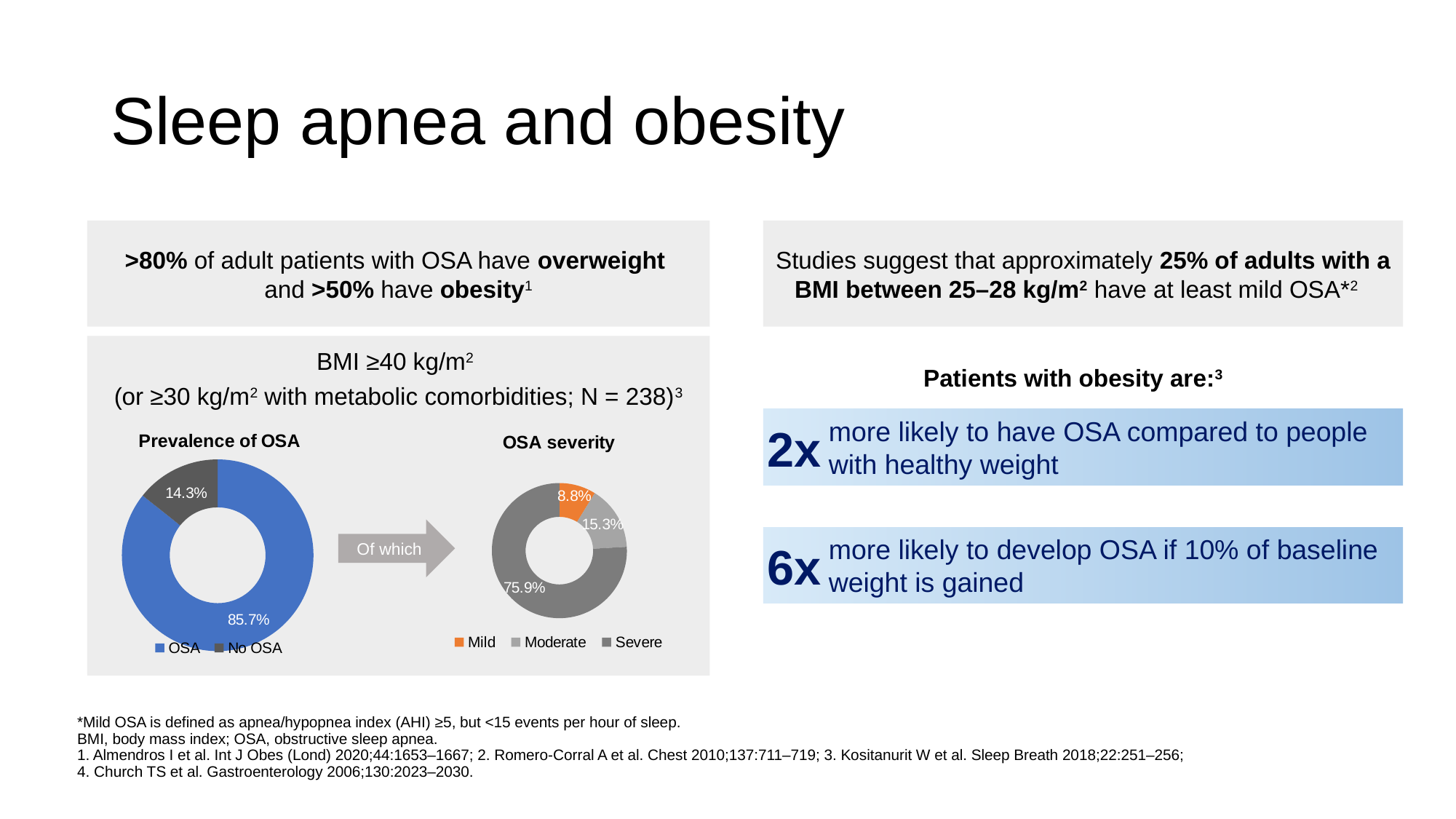
In the 'OSA severity' chart, what share of patients have moderate OSA? 15.3% In the 'OSA severity' chart, what share of patients have severe OSA? 75.9% What type of chart is the 'Prevalence of OSA' chart? Doughnut (pie) chart In the 'OSA severity' chart, what colour represents the Mild category? Orange In the 'OSA severity' chart, what share of patients have mild OSA? 8.8% In the 'Prevalence of OSA' chart, what percentage of patients have OSA? 85.7% In the 'OSA severity' chart, which severity category is the largest? Severe In the 'Prevalence of OSA' chart, what percentage of patients have no OSA? 14.3% In the 'OSA severity' chart, which severity category is the smallest? Mild In the 'OSA severity' chart, is the moderate share larger or smaller than the mild share? larger How many categories does the legend of the 'OSA severity' chart list? 3 In the 'Prevalence of OSA' chart, what is the difference between the OSA and No OSA shares? 71.4%